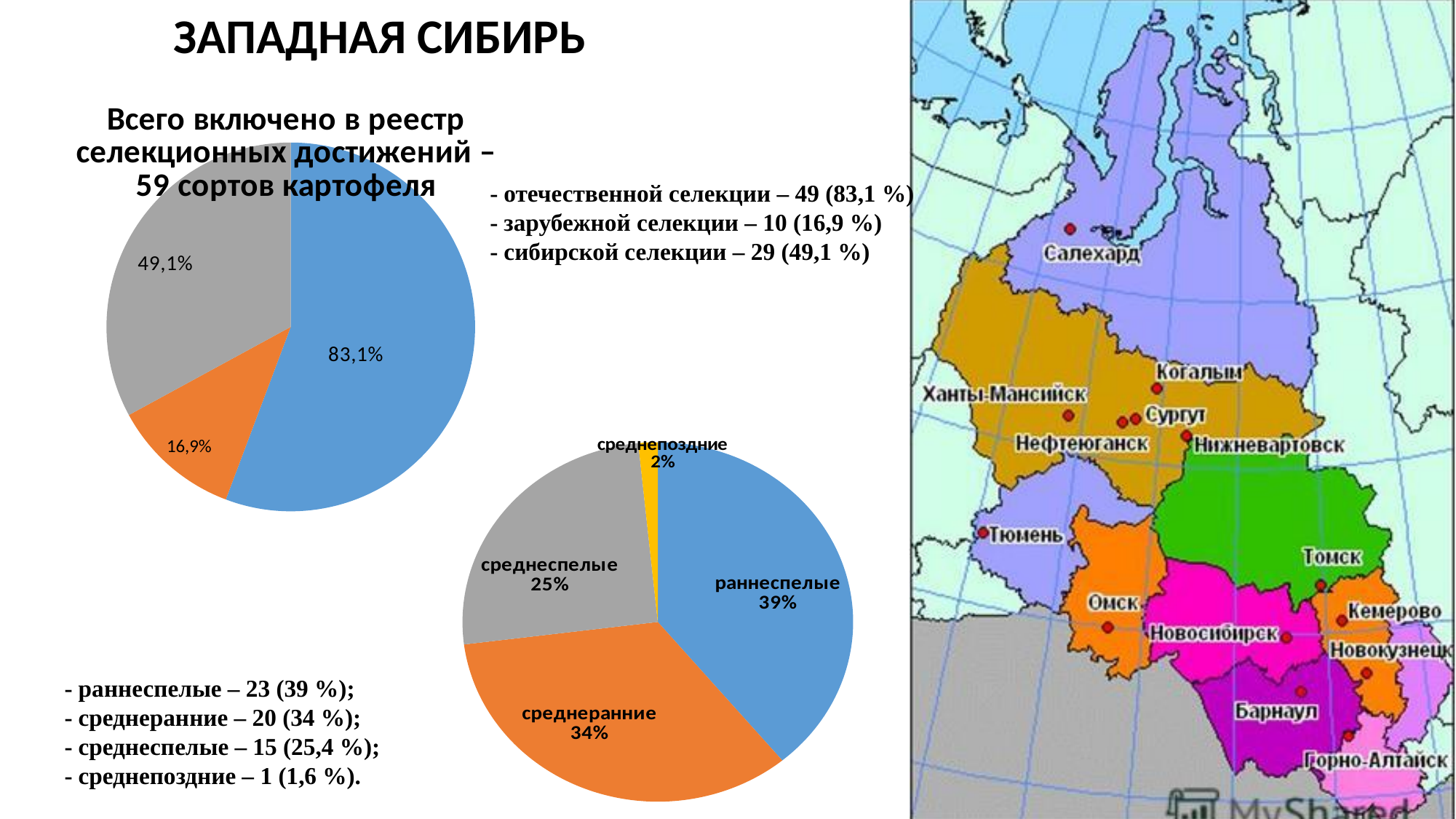
In the lower pie chart, which category has the largest slice? раннеспелые In the lower pie chart, what percentage is shown for среднеранние? 34% In the lower pie chart, what percentage is shown for раннеспелые? 39% In the lower pie chart, what percentage is shown for среднеспелые? 25% In the lower pie chart, what is the difference in percentage points between раннеспелые and среднеранние? 5 In the lower pie chart, what percentage is shown for среднепоздние? 2% In the lower pie chart, which slice is larger: среднеспелые or среднеранние? среднеранние In the upper-left pie chart, what is the percentage label on the largest (blue) slice? 83,1% What kind of chart is the lower pie chart with the labels раннеспелые, среднеранние, среднеспелые and среднепоздние? pie chart In the upper-left pie chart, what is the percentage label on the smallest (orange) slice? 16,9% How many slices does the lower pie chart have? 4 In the lower pie chart, which category has the smallest slice? среднепоздние